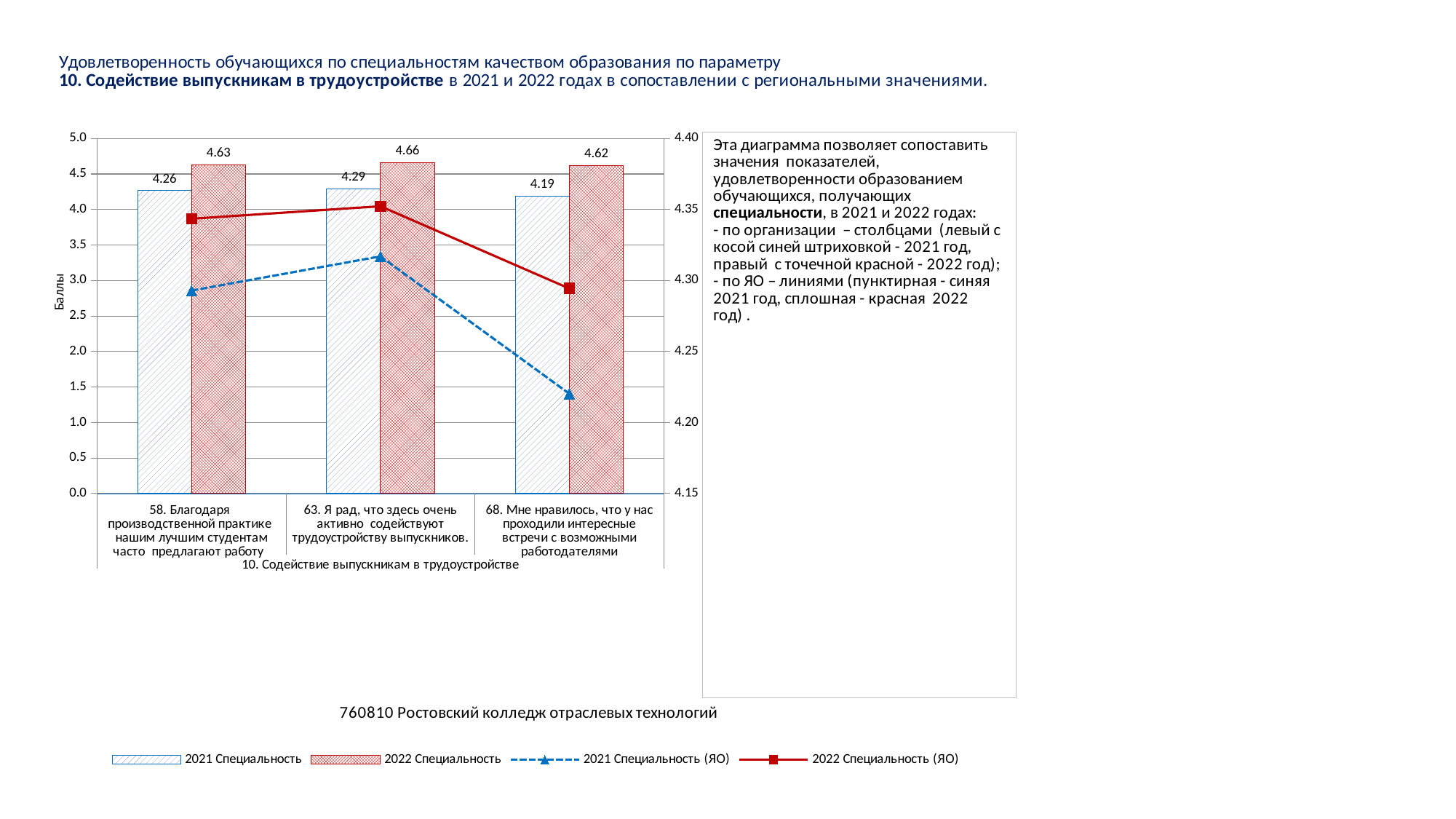
Which is larger for category 68: the 2021 Специальность bar or the 2022 Специальность bar? 2022 Специальность Is the value of the 2021 Специальность (ЯО) line for category 68 greater or less than 4.25 on the right axis? less Is the value of the 2022 Специальность (ЯО) line for category 63 greater or less than 4.30 on the right axis? greater What is the value of the 2022 Специальность bar for category 63 (Я рад, что здесь очень активно содействуют трудоустройству выпускников)? 4.66 Which category has the lowest 2021 Специальность bar? 68. Мне нравилось, что у нас проходили интересные встречи с возможными работодателями Which category has the highest 2022 Специальность bar? 63. Я рад, что здесь очень активно содействуют трудоустройству выпускников. What is the label of the vertical axis on the left? Баллы How many series does the legend list? 4 What is the difference between the 2022 and 2021 Специальность bars for category 58? 0.37 What is the value of the 2021 Специальность bar for category 58 (Благодаря производственной практике нашим лучшим студентам часто предлагают работу)? 4.26 What is the value of the 2021 Специальность bar for category 68 (Мне нравилось, что у нас проходили интересные встречи с возможными работодателями)? 4.19 How many categories are shown on the x axis? 3